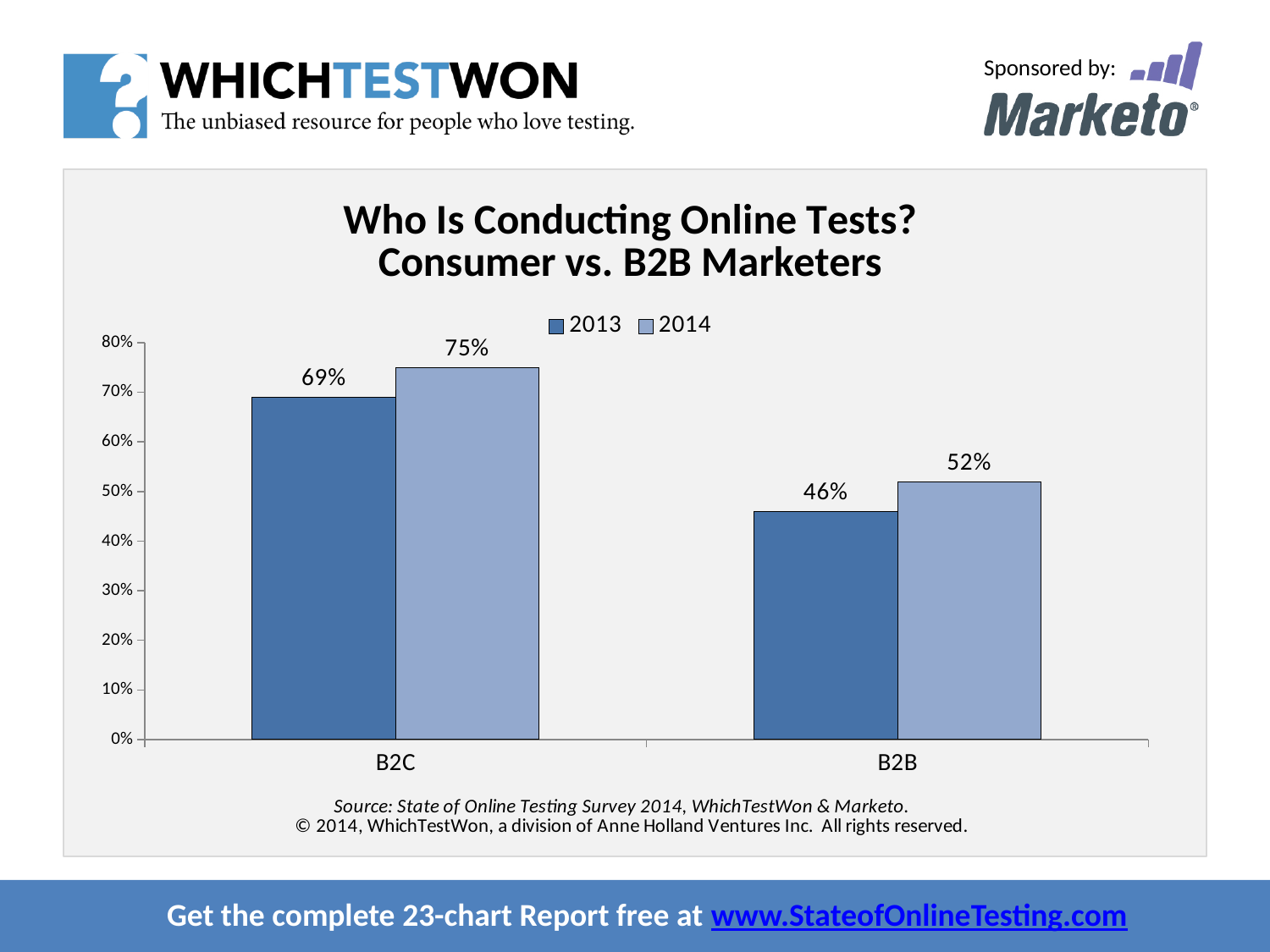
Which is larger, the 2013 value for B2C or the 2014 value for B2B? 2013 value for B2C Which category has the highest value in 2014? B2C What is the value for B2B in 2013? 46% How many categories are shown on the x axis? 2 What is the value for B2C in 2013? 69% What is the difference between the 2014 and 2013 values for B2C? 6% What is the value for B2C in 2014? 75% What kind of chart is shown on the slide? Bar chart How many series does the legend list? 2 What is the value for B2B in 2014? 52% Which category has the lowest value in 2013? B2B What is the difference between the B2C and B2B values in 2014? 23%